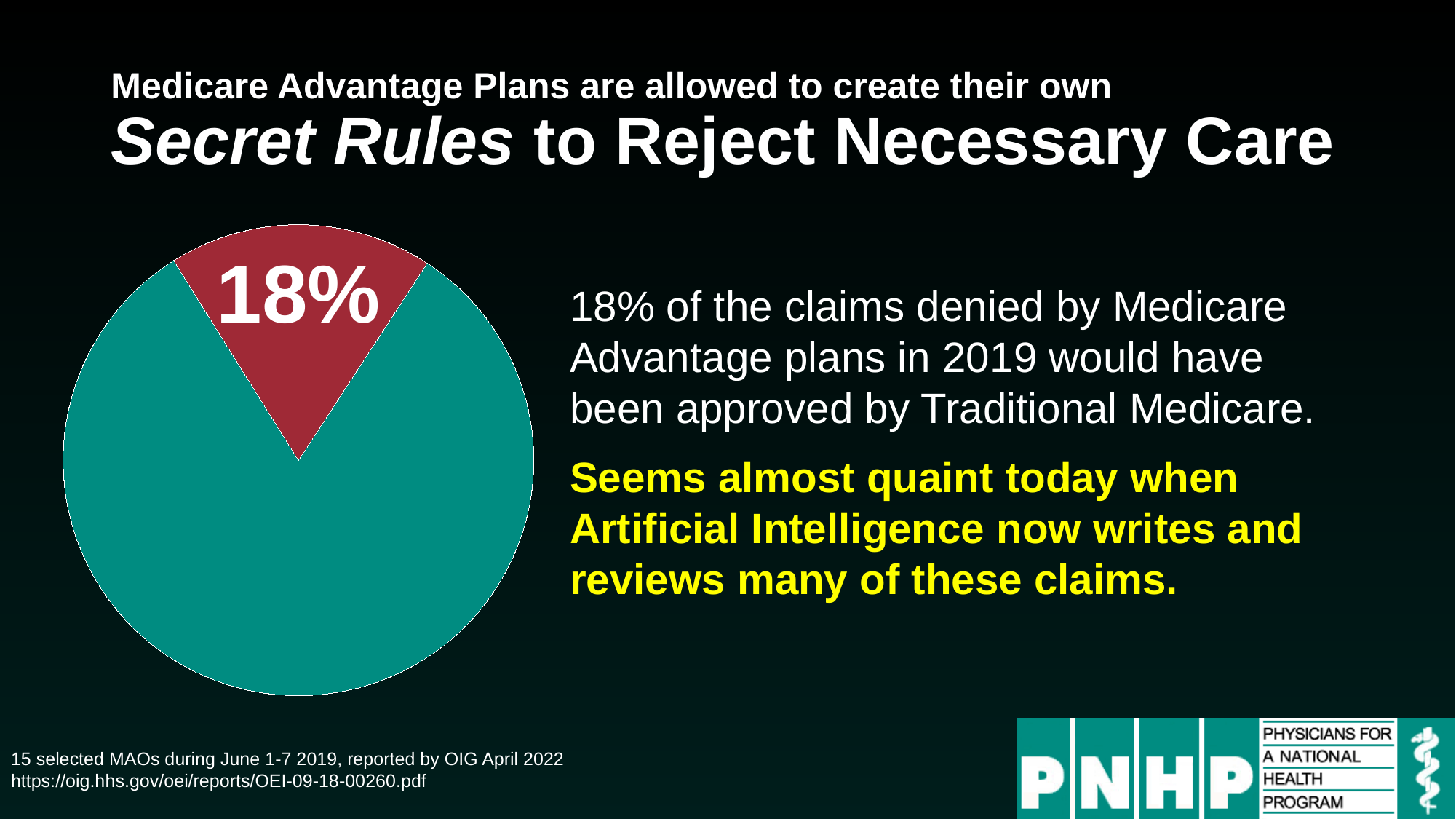
Which slice of the pie chart is larger, the red slice or the teal slice? the teal slice According to the slide, what does the 18% slice represent? claims denied by Medicare Advantage plans in 2019 that would have been approved by Traditional Medicare What value is printed on the red slice of the pie chart? 18% What share of the pie does the labelled slice represent? 18% What kind of chart is shown on the slide? pie chart Is the teal slice of the pie chart greater or less than 50% of the pie? greater How many slices does the pie chart have? 2 Is the red slice of the pie chart greater or less than 25% of the pie? less What colour is the slice labelled 18% in the pie chart? red